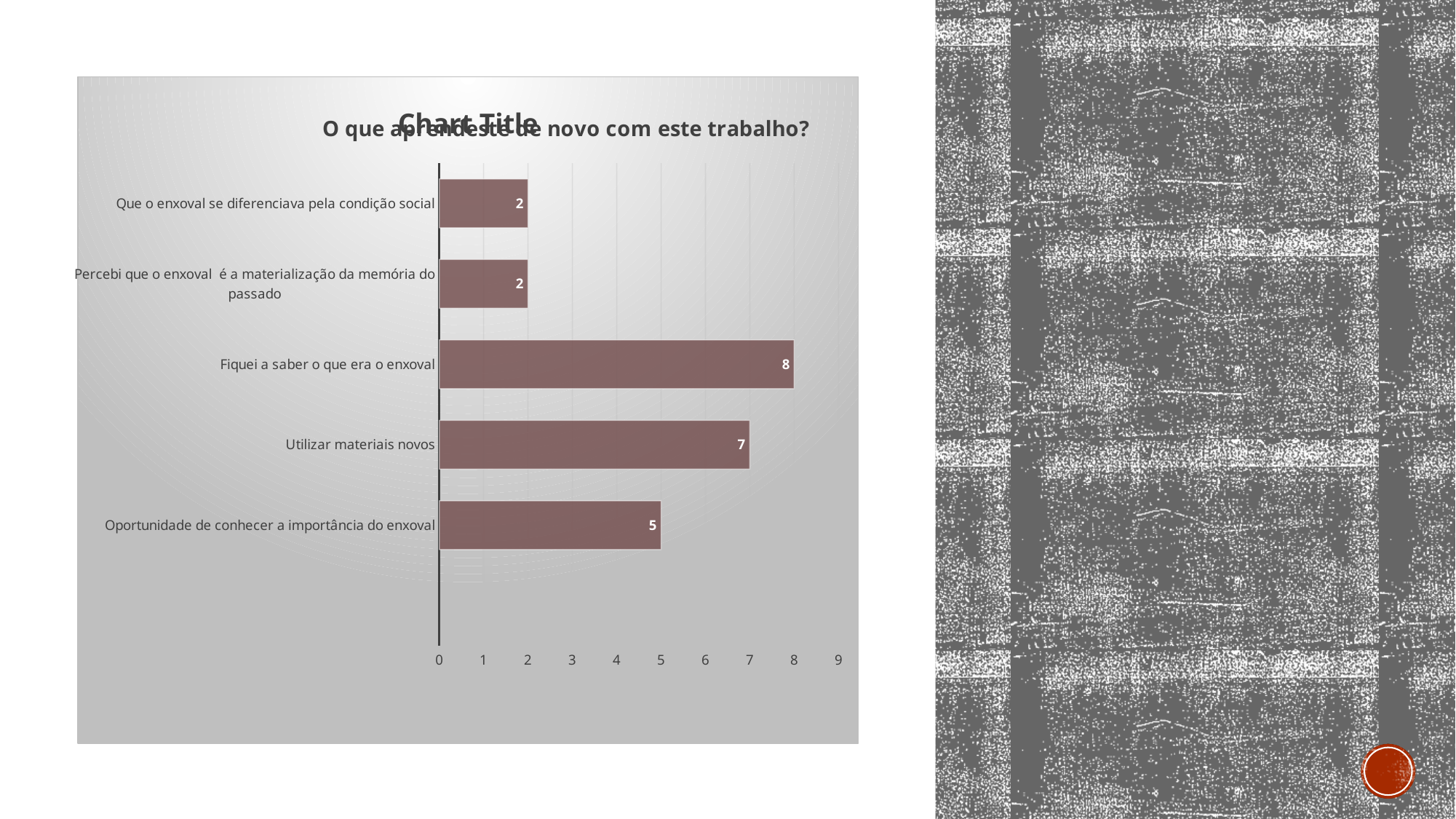
Which is larger: the value for "Oportunidade de conhecer a importância do enxoval" or the value for "Que o enxoval se diferenciava pela condição social"? Oportunidade de conhecer a importância do enxoval How many categories are shown in the chart? 5 What is the highest value shown on the horizontal axis? 9 What value is shown for "Utilizar materiais novos"? 7 What value is shown for "Percebi que o enxoval é a materialização da memória do passado"? 2 Which category has the highest value? Fiquei a saber o que era o enxoval What is the difference between the values for "Utilizar materiais novos" and "Oportunidade de conhecer a importância do enxoval"? 2 What value is shown for "Que o enxoval se diferenciava pela condição social"? 2 What is the difference between the values for "Fiquei a saber o que era o enxoval" and "Utilizar materiais novos"? 1 What kind of chart is shown on the slide? Bar chart What value is shown for "Oportunidade de conhecer a importância do enxoval"? 5 What value is shown for "Fiquei a saber o que era o enxoval"? 8